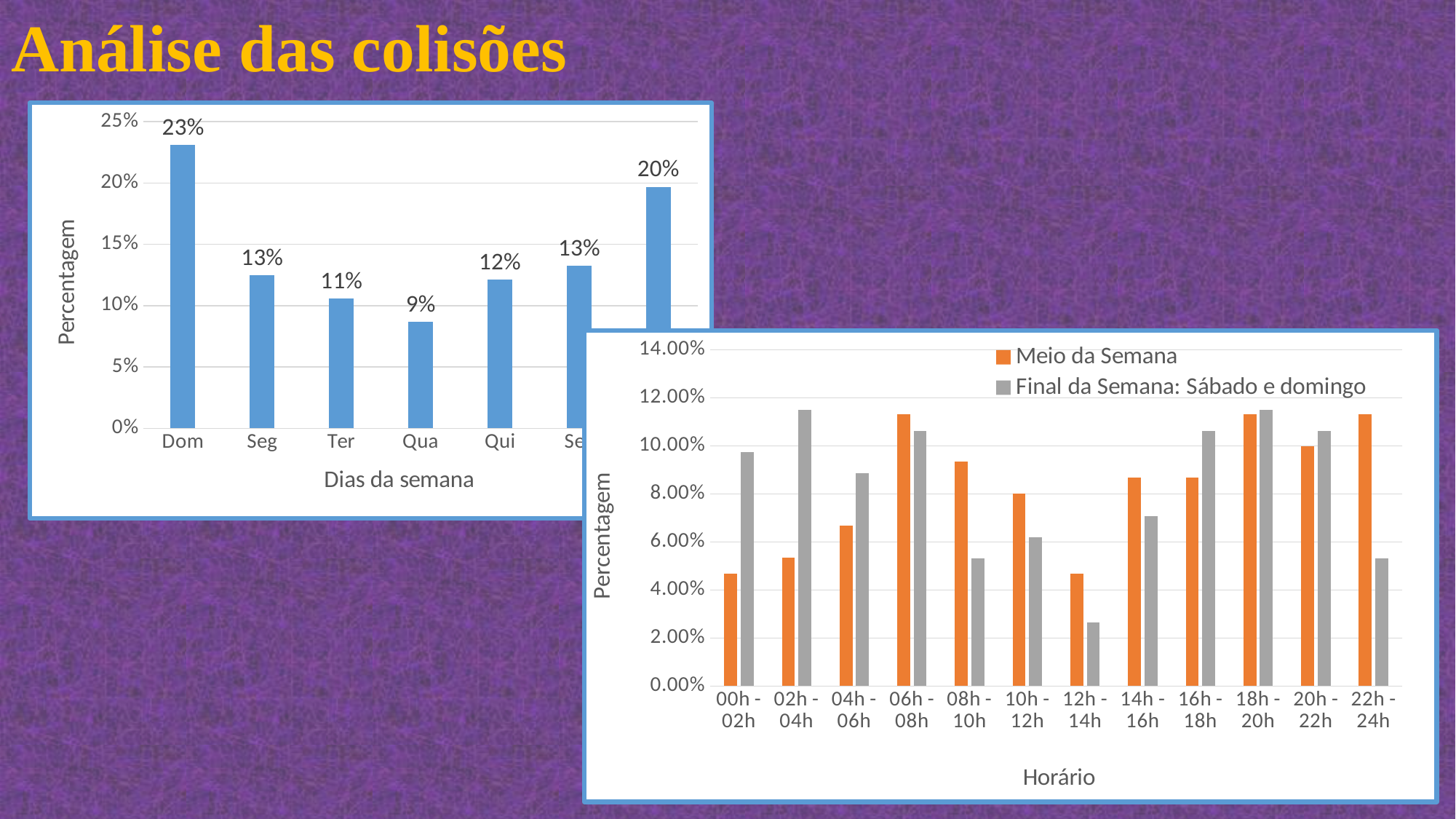
In the chart with x axis 'Dias da semana', what is the value for Dom? 23% In the chart with x axis 'Horário', is the 'Meio da Semana' value for 12h - 14h greater or less than 6.00%? less In the chart with x axis 'Dias da semana', what is the difference between the values for Dom and Qua? 14% In the chart with x axis 'Horário', is the 'Final da Semana: Sábado e domingo' value for 02h - 04h greater or less than 10.00%? greater In the chart with x axis 'Dias da semana', which day has the lowest value? Qua In the chart with x axis 'Dias da semana', which day has the highest value? Dom In the chart with x axis 'Horário', how many time intervals are shown on the x axis? 12 In the chart with x axis 'Horário', how many series does the legend list? 2 In the chart with x axis 'Dias da semana', which is larger, the value for Seg or the value for Qui? Seg What type of chart is the chart with x axis 'Horário'? Bar chart In the chart with x axis 'Dias da semana', what is the value for Ter? 11% In the chart with x axis 'Dias da semana', what is the value for Qua? 9%